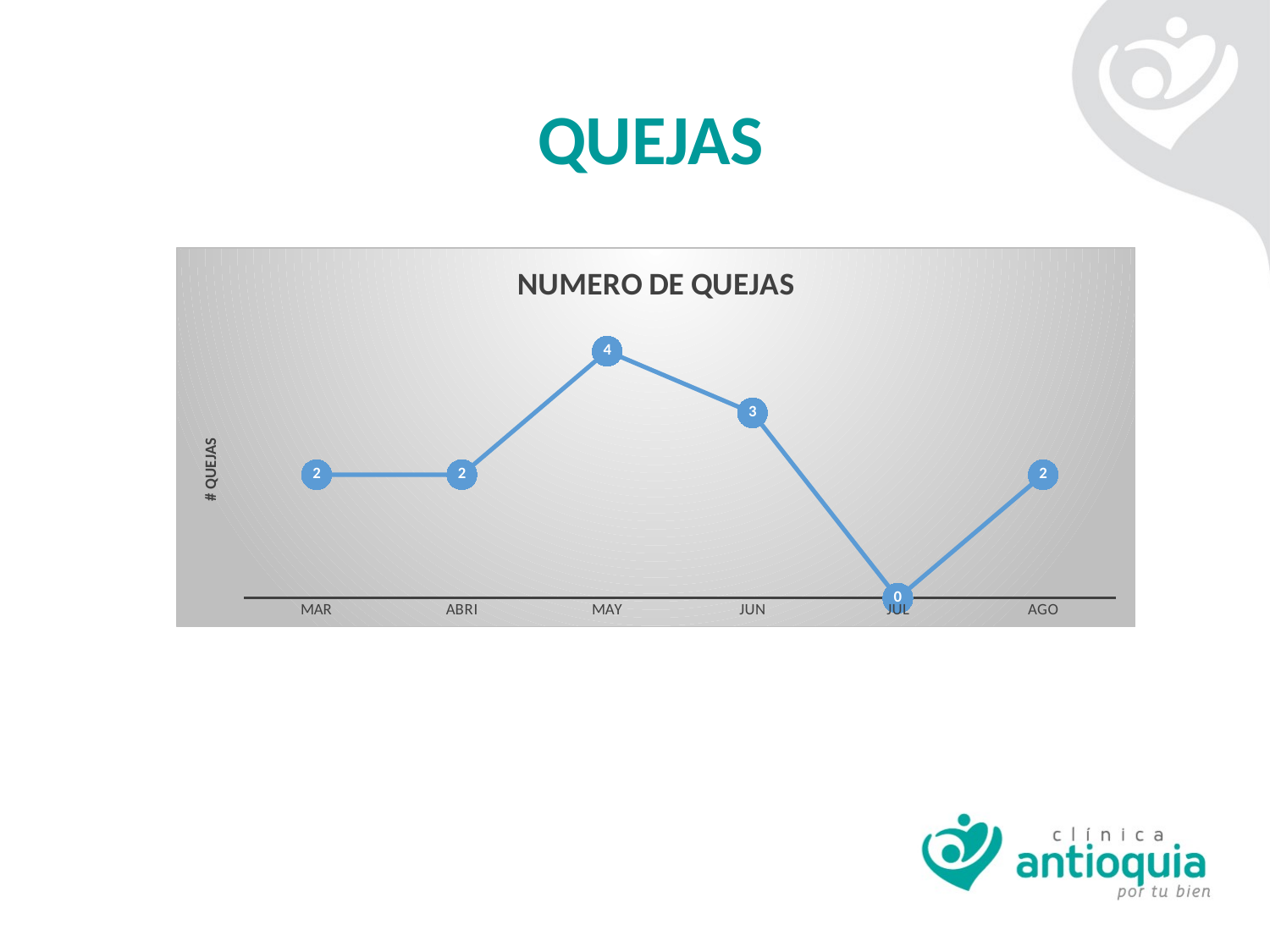
Which month has the highest number of complaints? MAY How many months are plotted on the chart? 6 What kind of chart is shown on the slide? Line chart What is the number of complaints for AGO? 2 What is the number of complaints (quejas) for MAY? 4 What is the number of complaints for JUL? 0 Do the number of complaints rise or fall from JUN to JUL? Fall What is the difference between the number of complaints in MAY and JUN? 1 Which month has the lowest number of complaints? JUL What is the number of complaints for JUN? 3 Which month has more complaints, JUN or AGO? JUN What is the title of the chart? NUMERO DE QUEJAS